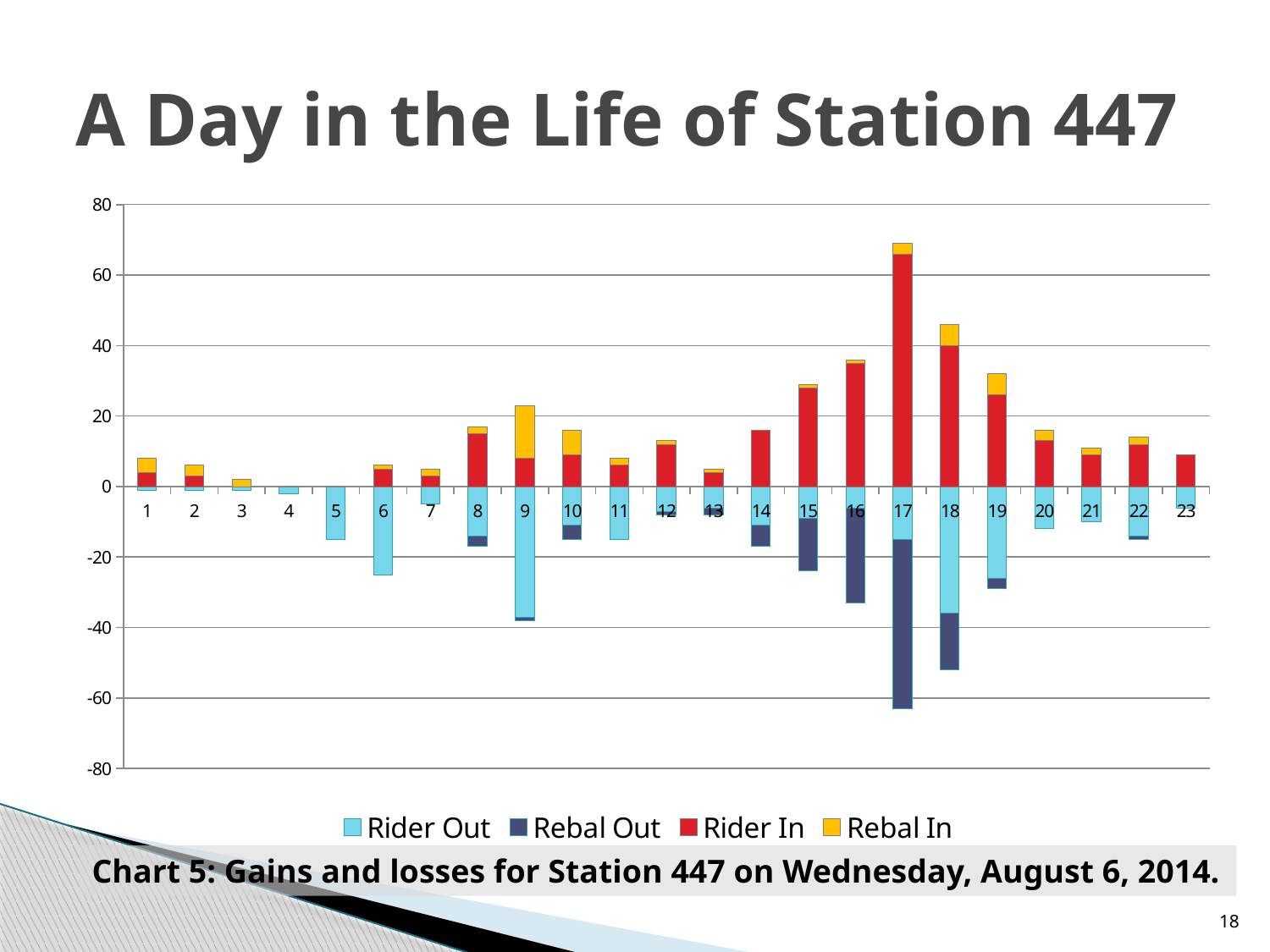
Is the negative stack for hour 9 below or above -20? below What is the caption printed below the chart? Chart 5: Gains and losses for Station 447 on Wednesday, August 6, 2014. Which hour has the largest Rebal In (yellow) segment? 9 Is the negative stack for hour 17 below or above -40? below Which hour has the largest negative (losses) stack? 17 Is the positive stack for hour 18 greater or less than 40? greater What kind of chart is shown on the slide? Stacked bar chart Which hour has the tallest positive (gains) stack? 17 How many series does the legend list? 4 Which hour has a larger positive stack, 17 or 18? 17 How many categories (hours) are shown along the x axis? 23